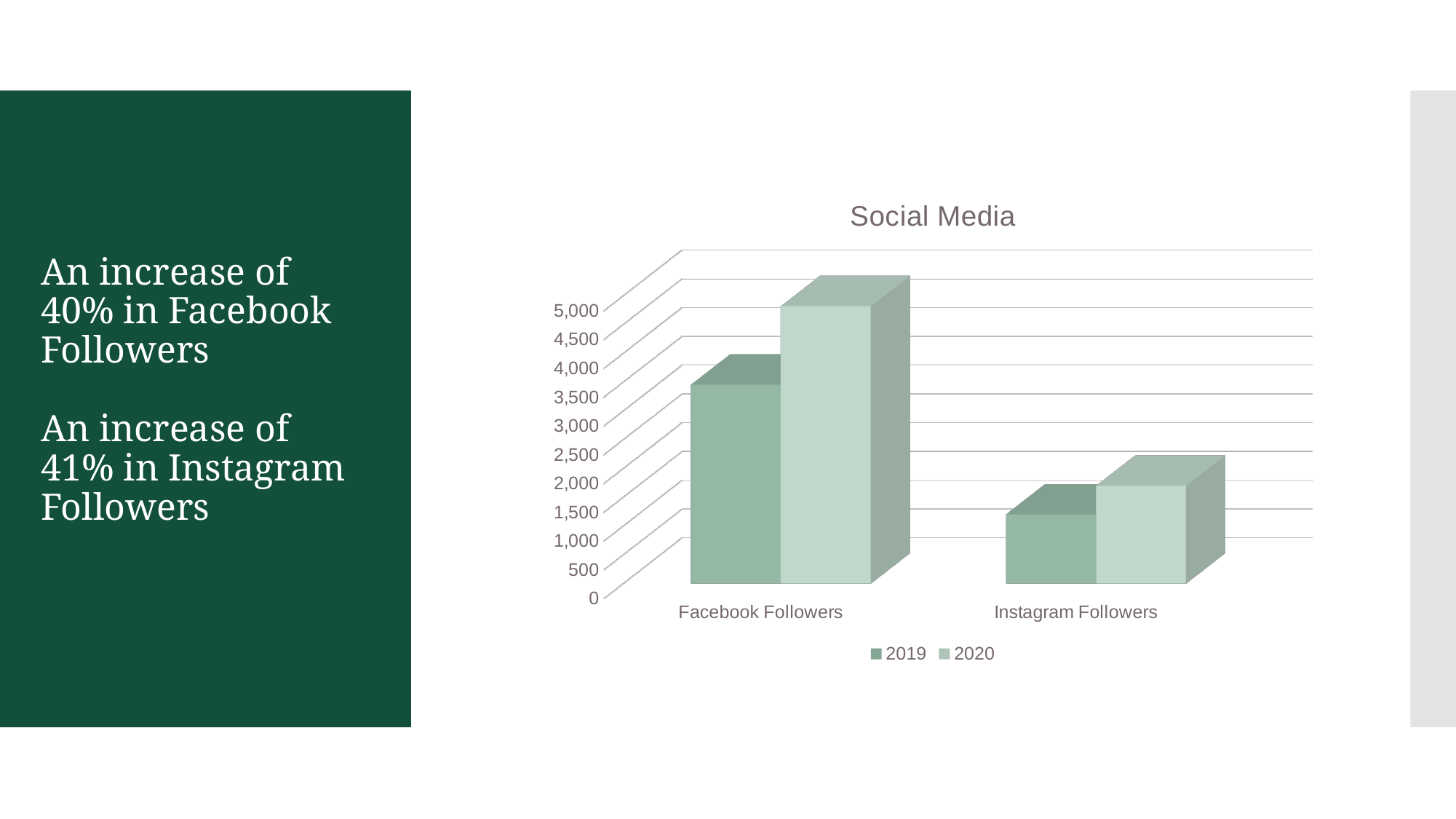
How many categories are shown on the x axis of the chart? 2 Is the 2020 value for Facebook Followers greater or less than 4,500? greater For Facebook Followers, which is larger: the 2019 value or the 2020 value? 2020 Is the 2019 value for Facebook Followers greater or less than 3,000? greater How many series does the chart legend list? 2 Is the 2019 value for Instagram Followers greater or less than 2,000? less Which bar is the shortest in the chart? Instagram Followers, 2019 Which bar is the tallest in the chart? Facebook Followers, 2020 For Instagram Followers, which is larger: the 2019 value or the 2020 value? 2020 Which years are listed in the chart legend? 2019 and 2020 What kind of chart is shown on the slide? Bar chart What is the title of the chart? Social Media